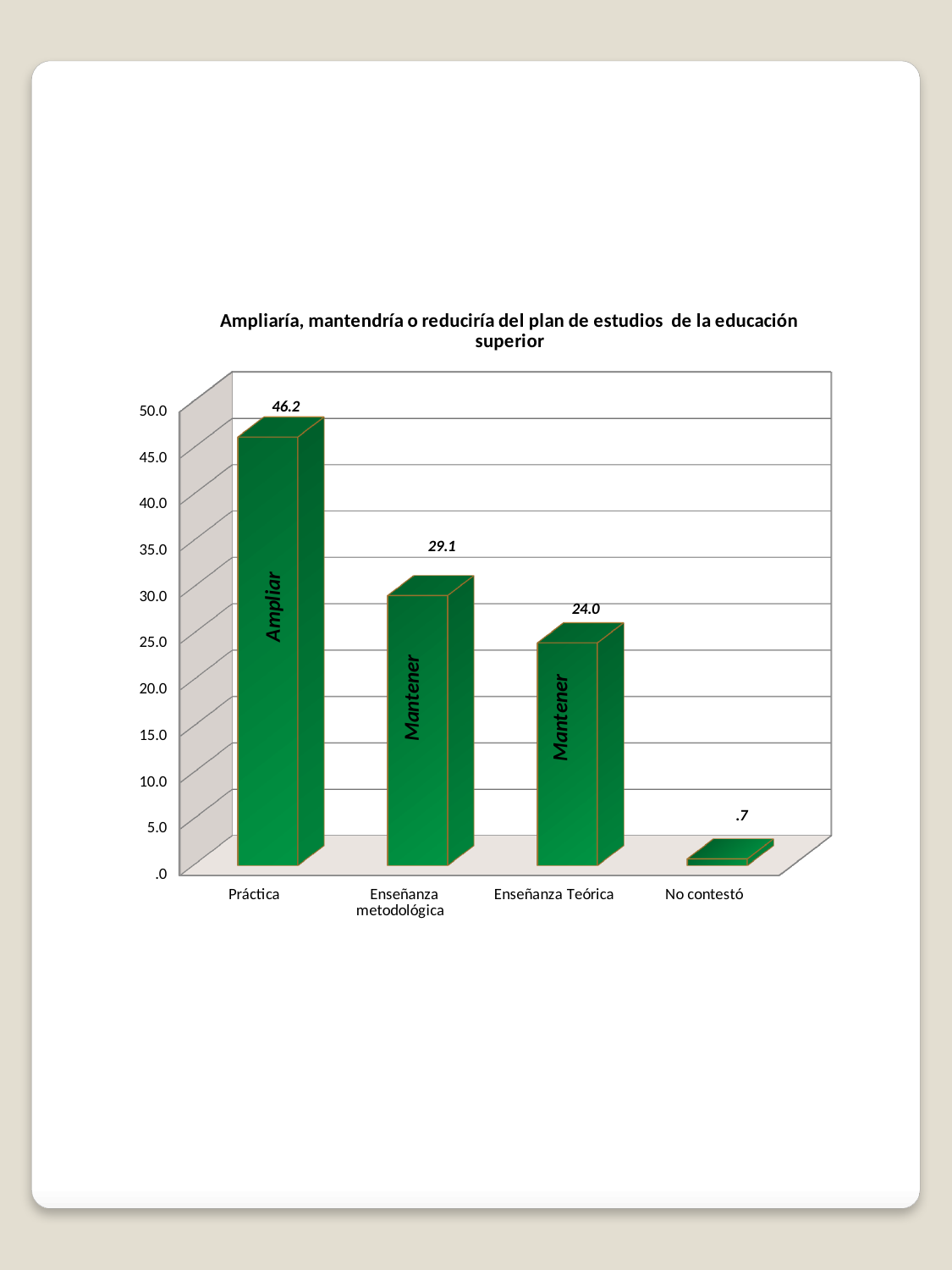
Which is larger, the value for Enseñanza metodológica or Enseñanza Teórica? Enseñanza metodológica What is the value for Práctica? 46.2 What is the value for Enseñanza Teórica? 24.0 How many categories are shown on the x axis? 4 What is the value for No contestó? .7 Which category has the lowest value? No contestó What is the difference between the values for Práctica and Enseñanza metodológica? 17.1 What kind of chart is shown? Bar chart What word is written inside the bar for Práctica? Ampliar Do the values rise or fall from left to right along the x axis? Fall What is the value for Enseñanza metodológica? 29.1 Which category has the highest value? Práctica